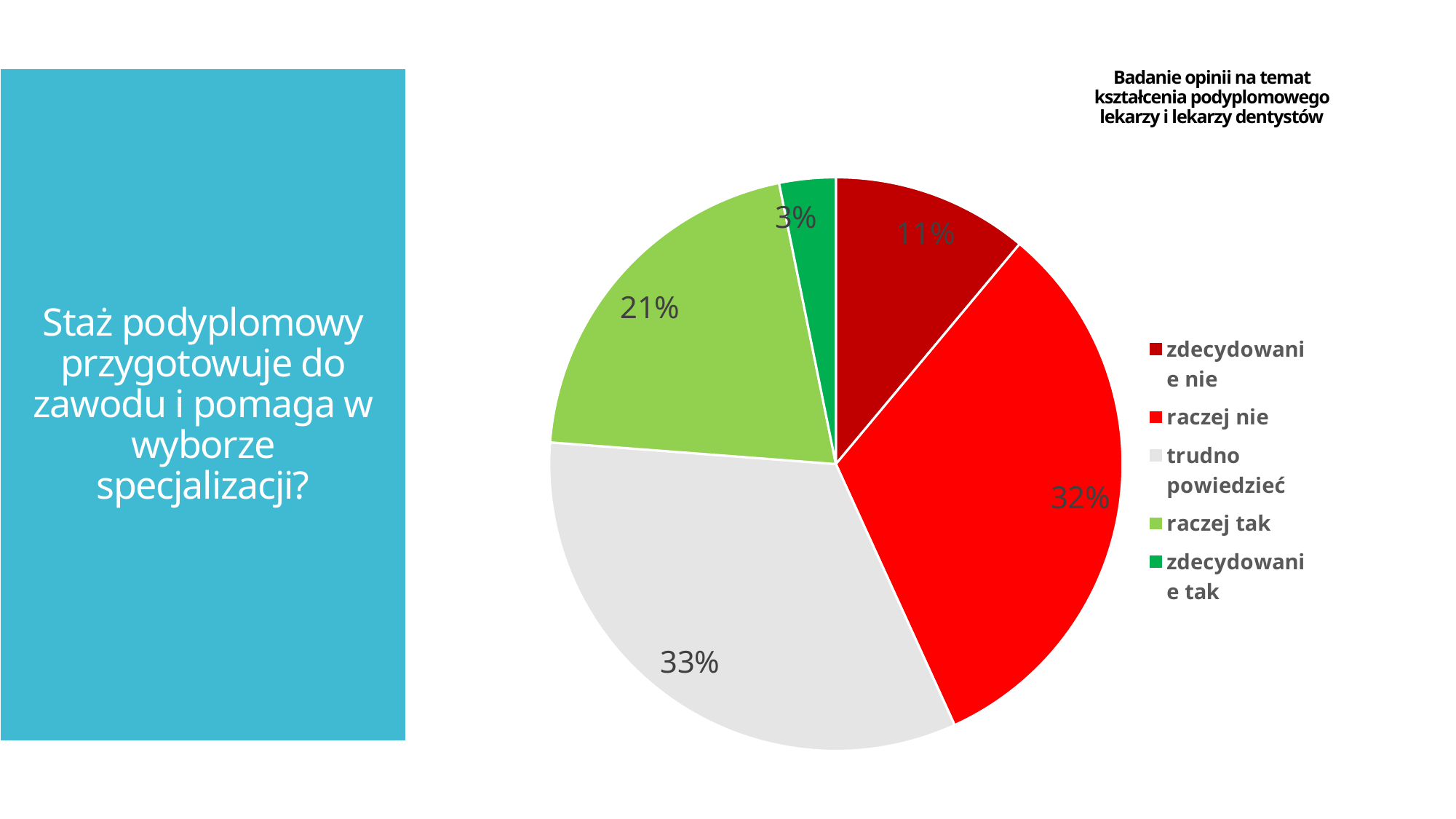
Which is larger, the share of "raczej tak" or the share of "zdecydowanie nie"? raczej tak Which category has the largest slice of the pie? trudno powiedzieć What is the difference between the shares of "raczej tak" and "zdecydowanie nie"? 10% Which category has the smallest slice of the pie? zdecydowanie tak What share of the pie does "zdecydowanie nie" have? 11% What kind of chart is shown on the slide? pie chart What share of the pie does "raczej tak" have? 21% What share of the pie does "raczej nie" have? 32% What colour is the "trudno powiedzieć" slice? light grey How many categories does the pie chart have? 5